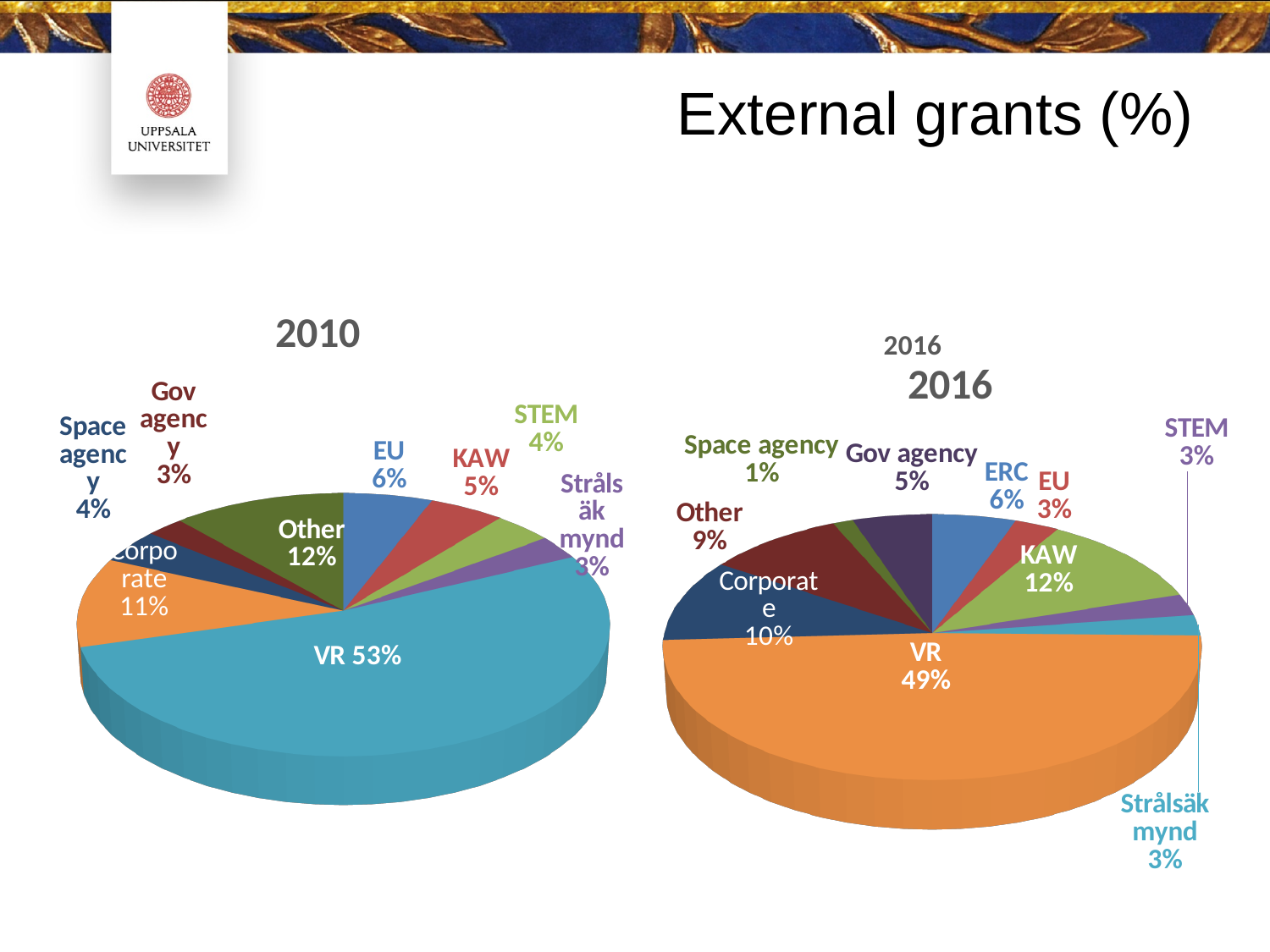
What is the difference between the VR share in 2010 and the VR share in 2016? 4 percentage points In the 2010 pie chart, what share does Corporate have? 11% In the 2016 pie chart, which category has the smallest share? Space agency In the 2010 pie chart, what share does VR have? 53% In the 2016 pie chart, what share does Space agency have? 1% In the 2016 pie chart, what share does KAW have? 12% In the 2016 pie chart, which is larger: the share for Other or the share for Corporate? Corporate How many categories are shown in the 2016 pie chart? 10 In the 2016 pie chart, which category has the largest share? VR In the 2010 pie chart, which category has the largest share? VR What type of chart is used for the 2010 data? Pie chart In the 2010 pie chart, what is the difference between the Other share and the EU share? 6 percentage points